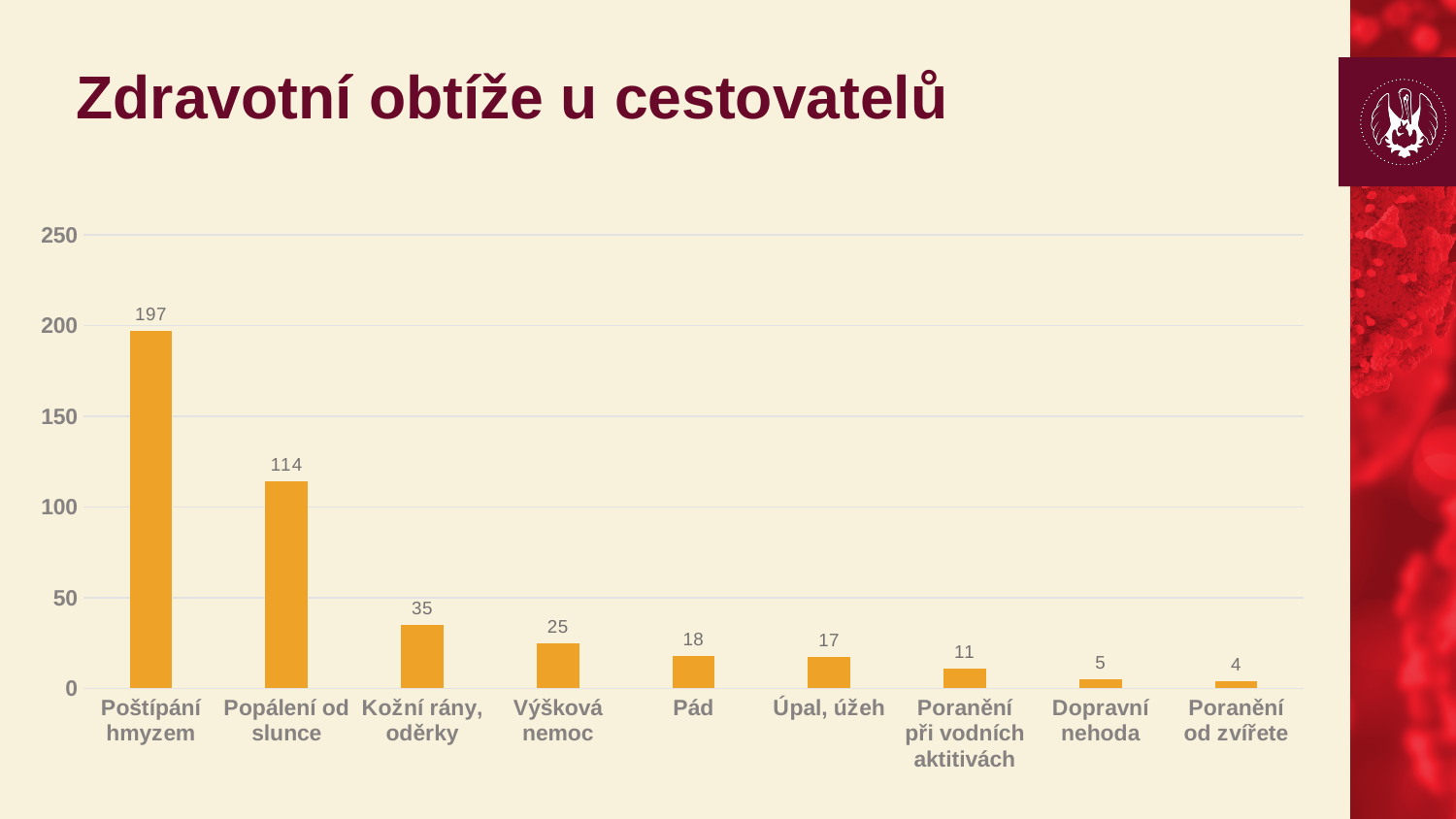
What is the value for Výšková nemoc? 25 How many categories are shown on the x axis? 9 What is the title of the slide? Zdravotní obtíže u cestovatelů What is the value for Poštípání hmyzem? 197 What is the difference between the values for Poštípání hmyzem and Popálení od slunce? 83 Which category has the lowest value? Poranění od zvířete Is the value for Kožní rány, oděrky greater or less than 50? less What is the value for Popálení od slunce? 114 Which category has the highest value? Poštípání hmyzem What is the value for Dopravní nehoda? 5 What kind of chart is shown on the slide? bar chart Which is larger, the value for Pád or the value for Úpal, úžeh? Pád